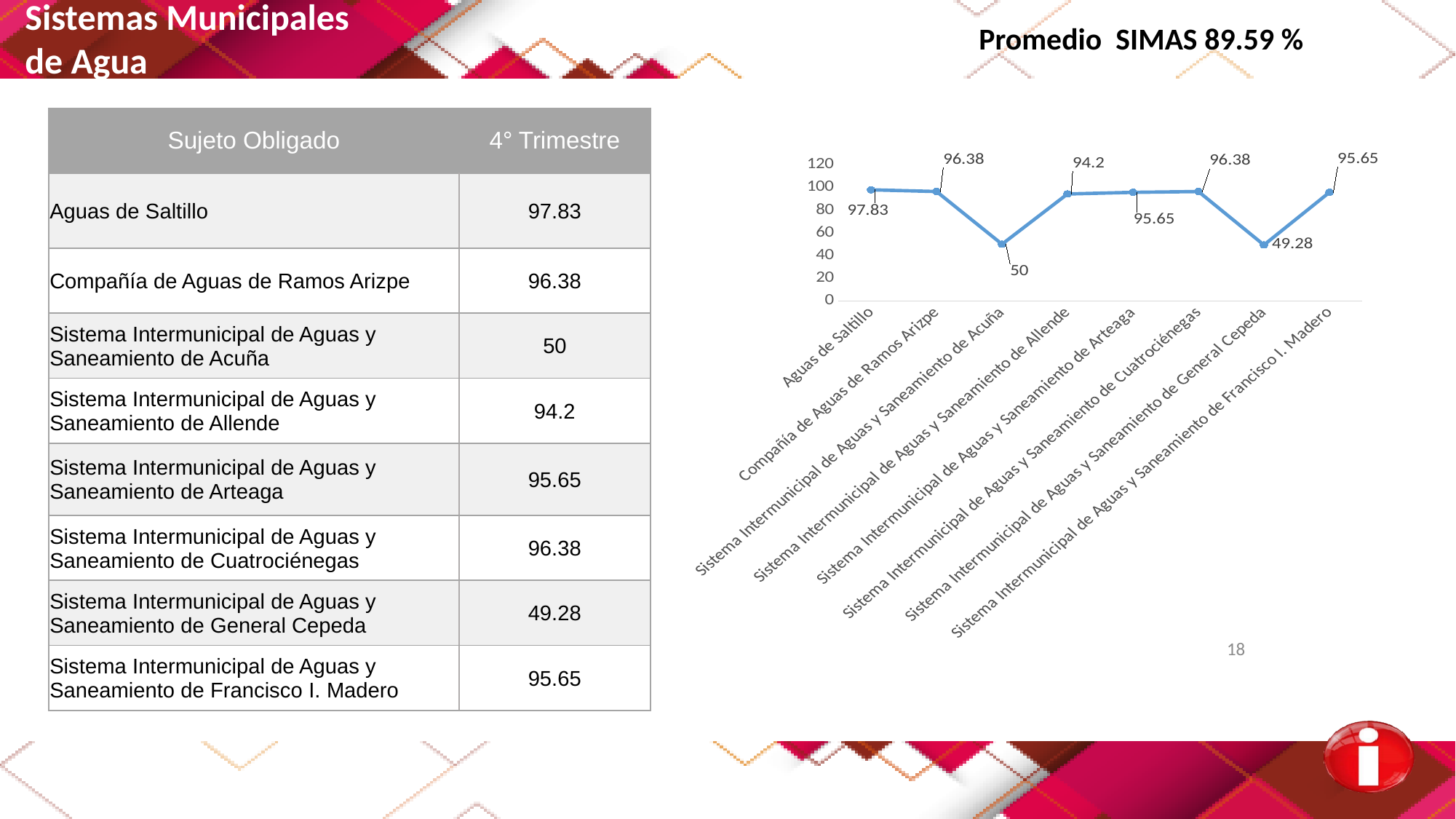
How many categories are plotted in the chart? 8 What is the difference between the values for Aguas de Saltillo and Sistema Intermunicipal de Aguas y Saneamiento de Acuña? 47.83 Which category has the lowest value in the chart? Sistema Intermunicipal de Aguas y Saneamiento de General Cepeda Which is larger: the value for Compañía de Aguas de Ramos Arizpe or the value for Sistema Intermunicipal de Aguas y Saneamiento de Allende? Compañía de Aguas de Ramos Arizpe Which category has the highest value in the chart? Aguas de Saltillo What is the value for Sistema Intermunicipal de Aguas y Saneamiento de General Cepeda in the chart? 49.28 What type of chart is shown on the slide? line chart What is the value for Sistema Intermunicipal de Aguas y Saneamiento de Allende in the chart? 94.2 What is the value for Aguas de Saltillo in the chart? 97.83 What is the difference between the values for Sistema Intermunicipal de Aguas y Saneamiento de Arteaga and Sistema Intermunicipal de Aguas y Saneamiento de General Cepeda? 46.37 Is the value for Sistema Intermunicipal de Aguas y Saneamiento de General Cepeda greater or less than 60? less What is the value for Sistema Intermunicipal de Aguas y Saneamiento de Acuña in the chart? 50